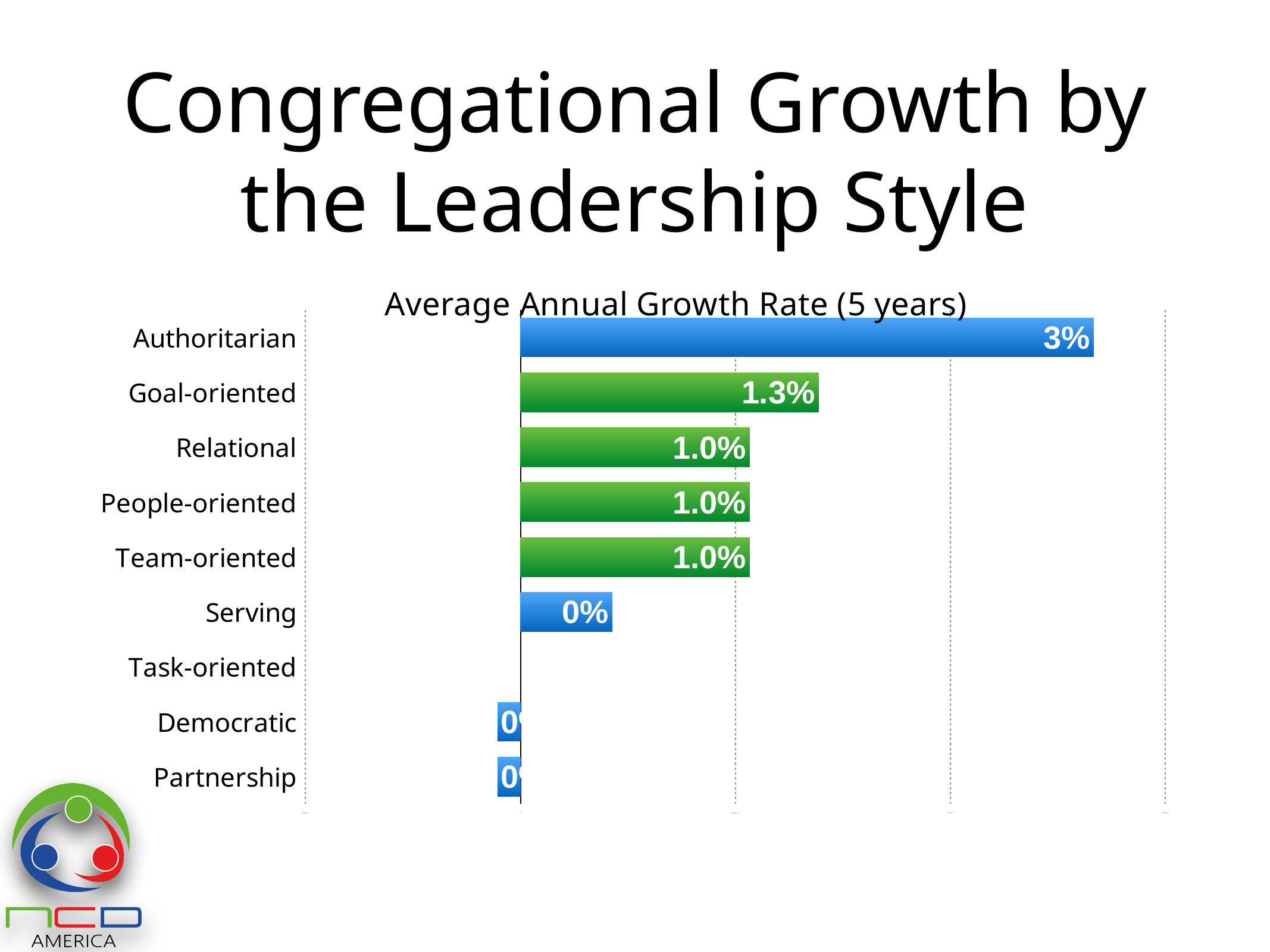
What is the difference between the growth rates for Goal-oriented and Team-oriented leadership? 0.3% What kind of chart is shown on the slide? Bar chart What is the title of the chart? Average Annual Growth Rate (5 years) What value is shown for the Relational leadership style? 1.0% How many leadership styles are listed on the chart? 9 What is the difference between the growth rates for Authoritarian and Goal-oriented leadership? 1.7% What is the average annual growth rate for Authoritarian leadership? 3% Which has a higher growth rate, Goal-oriented or People-oriented leadership? Goal-oriented What is the average annual growth rate for Goal-oriented leadership? 1.3% Which leadership style has the highest average annual growth rate? Authoritarian What colour is the bar for Authoritarian leadership? Blue What value is shown for the Serving leadership style? 0%